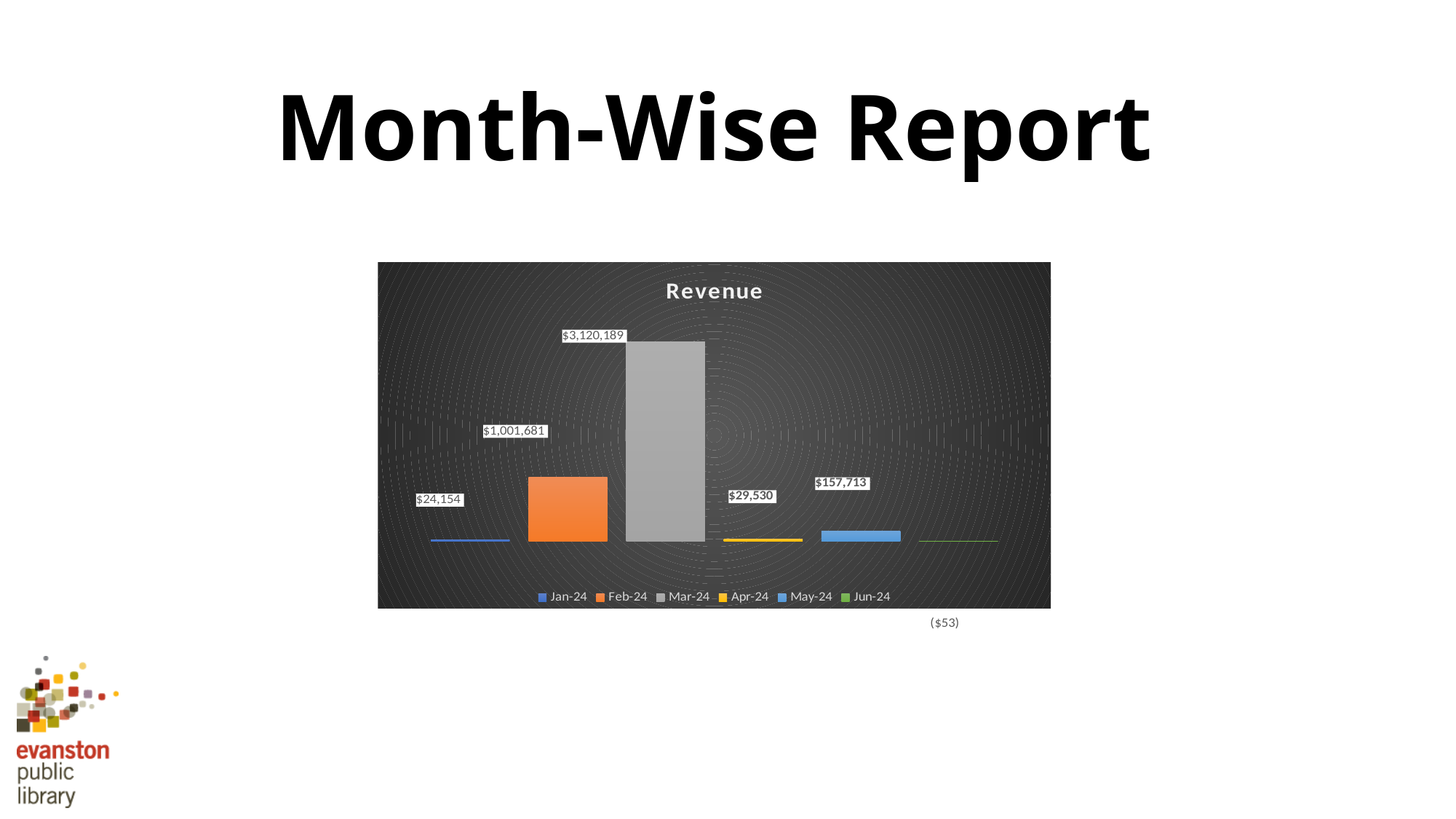
What is the revenue value for Feb-24? $1,001,681 What is the revenue value for May-24? $157,713 What type of chart is shown on the slide? bar chart What is the revenue value for Jan-24? $24,154 Which is larger, the revenue for Apr-24 or May-24? May-24 How many series does the legend list? 6 What is the difference between the revenue for Mar-24 and Feb-24? $2,118,508 What is the revenue value for Mar-24? $3,120,189 What is the title of the chart? Revenue Which month has the lowest revenue? Jun-24 What is the revenue value for Jun-24? ($53) Which month has the highest revenue? Mar-24